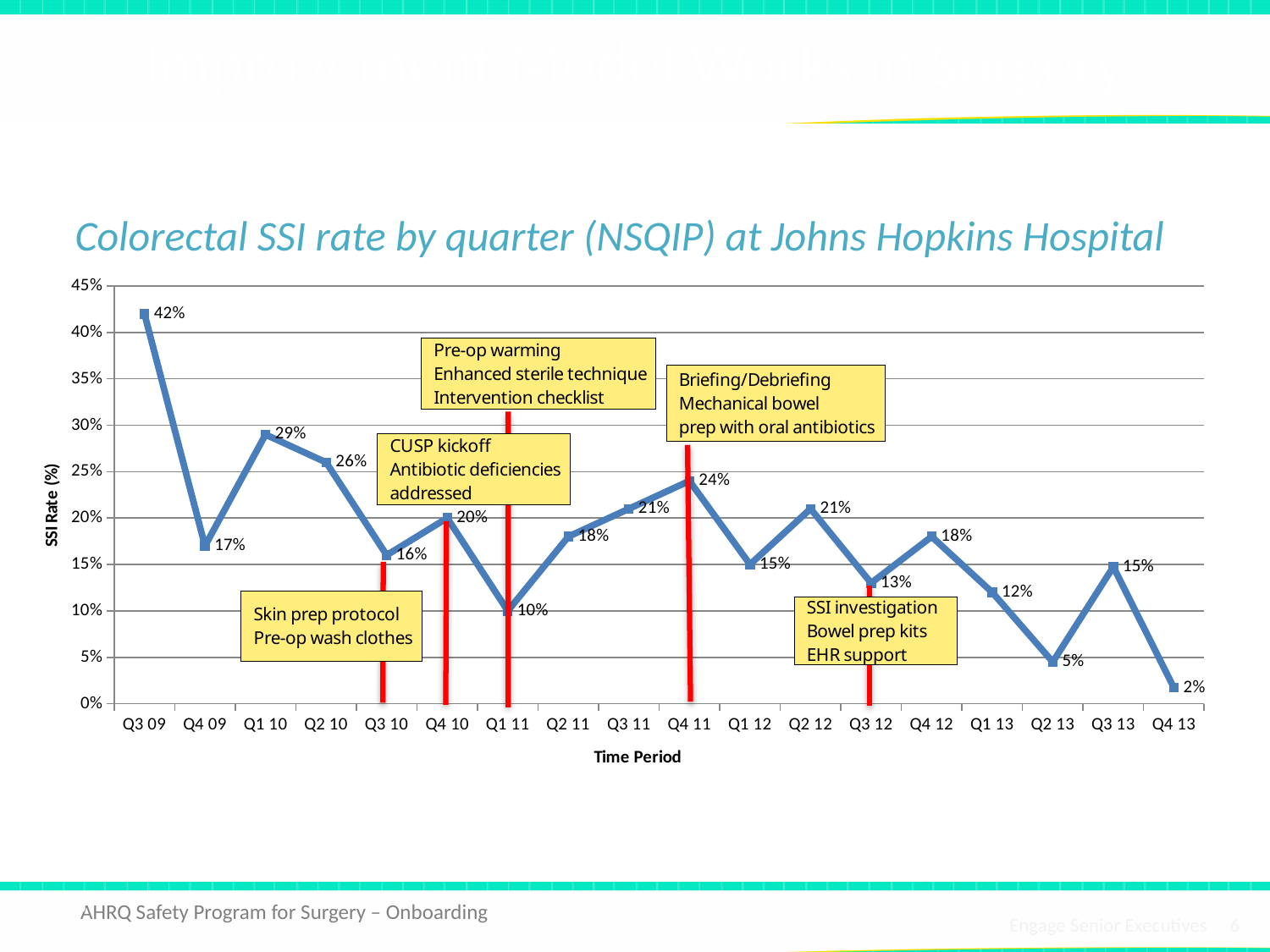
What is the SSI rate for Q1 11? 10% What is the SSI rate for Q2 13? 5% Which quarter has the lowest SSI rate? Q4 13 What kind of chart is shown on the slide? Line chart Which quarter has the highest SSI rate? Q3 09 What is the difference between the SSI rate in Q3 09 and in Q4 13? 40% What is the SSI rate for Q4 11? 24% What is the title of the y axis? SSI Rate (%) How many quarters are plotted on the chart? 18 What is the SSI rate for Q3 09? 42% Which quarter has a higher SSI rate, Q1 10 or Q2 10? Q1 10 Overall, does the SSI rate rise or fall from Q3 09 to Q4 13? Fall